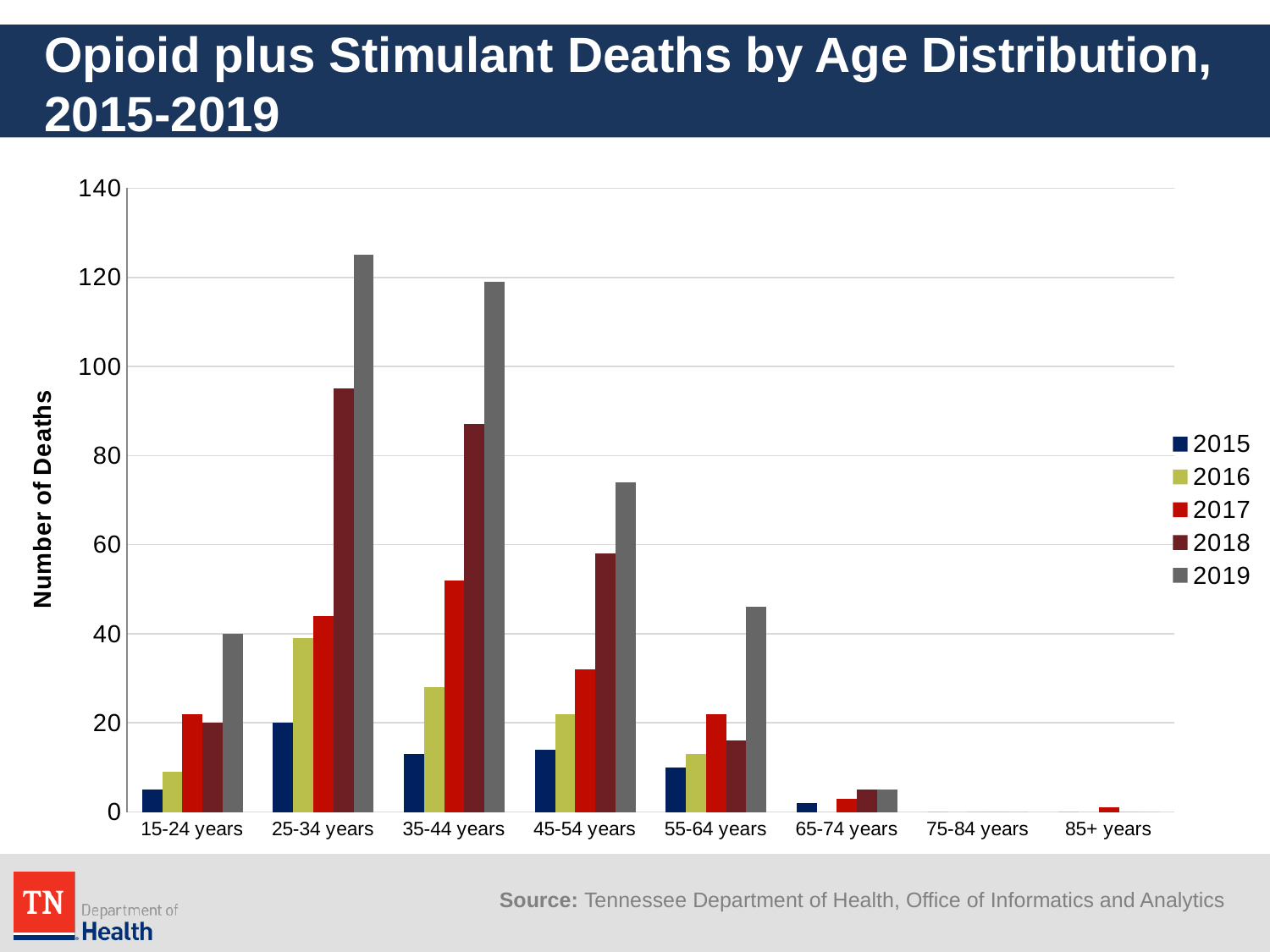
Is the 2018 value for 35-44 years greater or less than 80? greater What kind of chart is shown on the slide? bar chart What is the label on the vertical axis? Number of Deaths Which age group has the highest number of deaths for 2019? 25-34 years Which year has the lowest number of deaths for the 15-24 years group? 2015 For the 25-34 years group, do the values rise or fall from 2015 to 2019? rise Which is larger for 55-64 years: the 2017 value or the 2018 value? 2017 How many series does the legend list? 5 Is the 2019 value for 25-34 years greater or less than 120? greater How many age groups are shown on the x axis? 8 Is the 2019 value for 55-64 years greater or less than 40? greater Which is larger for 2019: the value for 35-44 years or the value for 45-54 years? 35-44 years